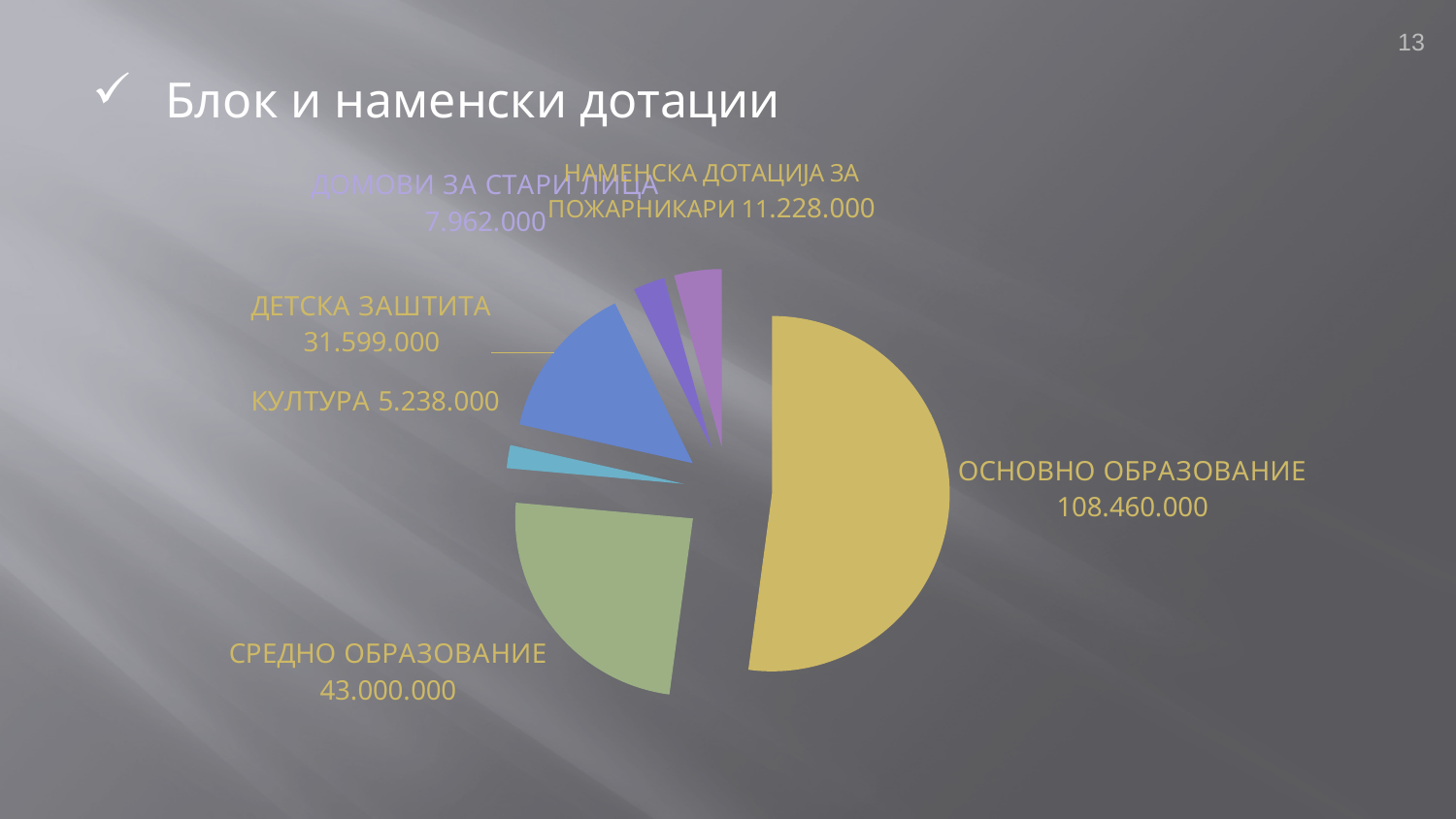
How many slices does the pie chart have? 6 What is the value for СРЕДНО ОБРАЗОВАНИЕ in the pie chart? 43.000.000 What is the value for ОСНОВНО ОБРАЗОВАНИЕ in the pie chart? 108.460.000 What is the value for КУЛТУРА in the pie chart? 5.238.000 What type of chart is shown on the slide? Pie chart What is the value for ДЕТСКА ЗАШТИТА in the pie chart? 31.599.000 What is the difference between the values for НАМЕНСКА ДОТАЦИЈА ЗА ПОЖАРНИКАРИ and ДОМОВИ ЗА СТАРИ ЛИЦА? 3.266.000 Which category has the largest slice in the pie chart? ОСНОВНО ОБРАЗОВАНИЕ What is the value for НАМЕНСКА ДОТАЦИЈА ЗА ПОЖАРНИКАРИ in the pie chart? 11.228.000 Which category has the smallest slice in the pie chart? КУЛТУРА What is the difference between the values for ОСНОВНО ОБРАЗОВАНИЕ and СРЕДНО ОБРАЗОВАНИЕ? 65.460.000 Which is larger, the value for ДЕТСКА ЗАШТИТА or the value for ДОМОВИ ЗА СТАРИ ЛИЦА? ДЕТСКА ЗАШТИТА